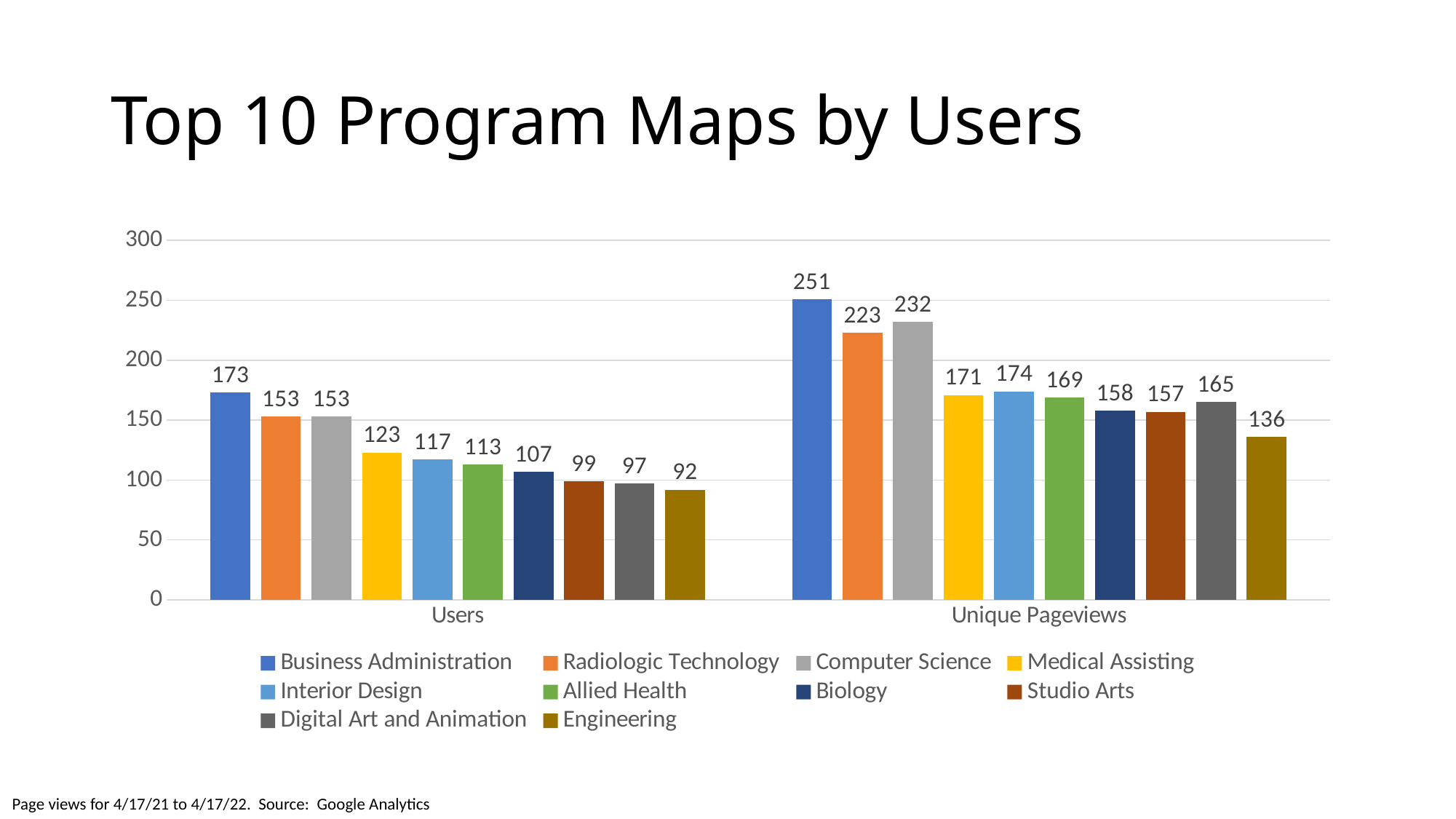
How many categories are shown on the x axis? 2 What is the Users value for Business Administration? 173 What is the Unique Pageviews value for Engineering? 136 Which program has the lowest Users value? Engineering What is the difference between the Users values for Medical Assisting and Biology? 16 What is the title of the chart? Top 10 Program Maps by Users Which program has the highest Unique Pageviews value? Business Administration What is the Unique Pageviews value for Computer Science? 232 What kind of chart is shown on the slide? Bar chart Which is larger, the Unique Pageviews value for Radiologic Technology or for Computer Science? Computer Science How many series does the legend list? 10 What is the difference between the Unique Pageviews and Users values for Business Administration? 78